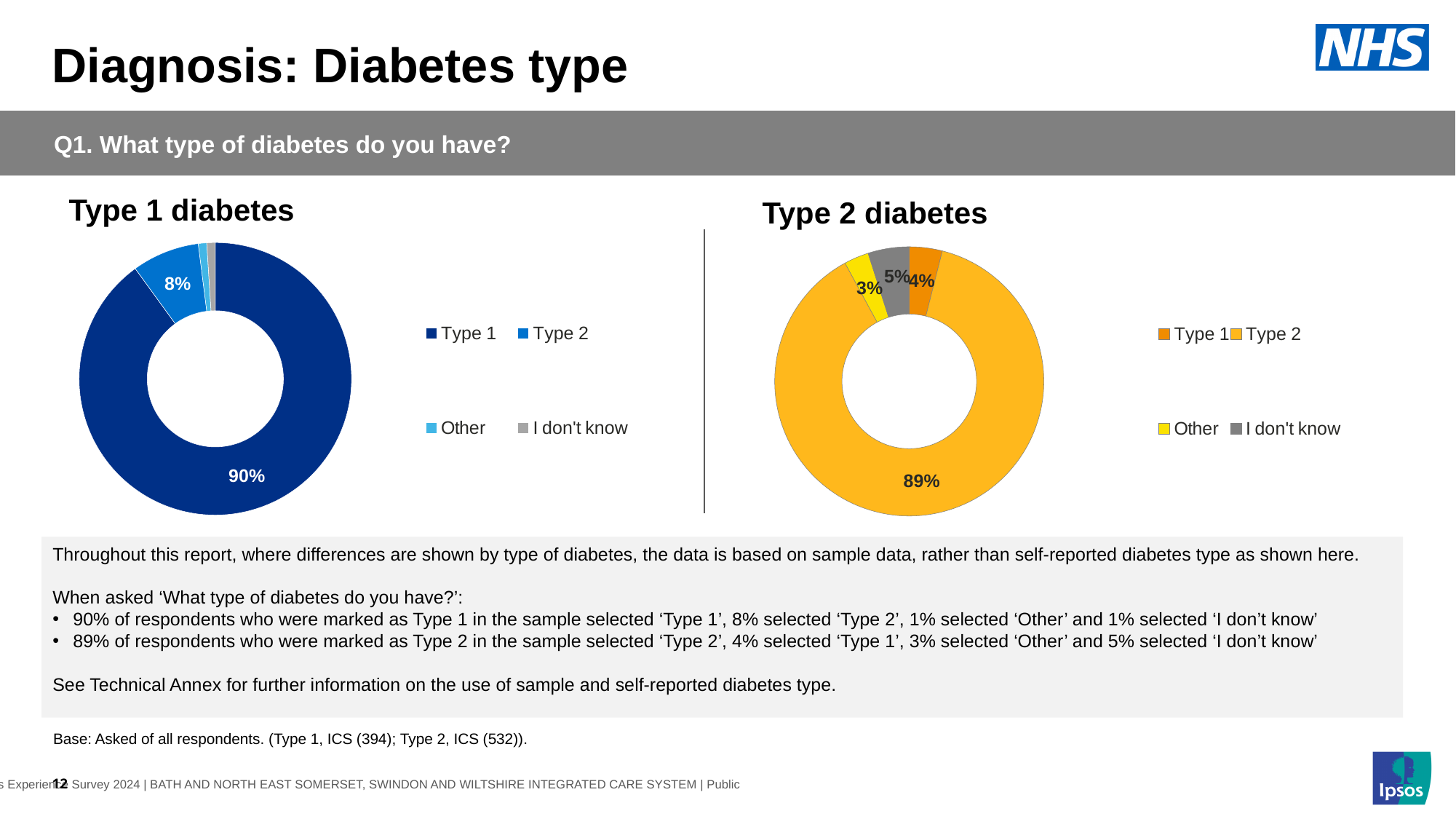
In the 'Type 2 diabetes' chart, what percentage selected 'I don't know'? 5% What kind of chart is the 'Type 1 diabetes' chart? Doughnut (pie) chart In the 'Type 2 diabetes' chart, what percentage selected 'Type 2'? 89% In the 'Type 1 diabetes' chart, what percentage selected 'Type 1'? 90% In the 'Type 1 diabetes' chart, what percentage selected 'Type 2'? 8% In the 'Type 2 diabetes' chart, what percentage selected 'Other'? 3% In the 'Type 2 diabetes' chart, which category has the smallest share? Other In the 'Type 2 diabetes' chart, which is larger: the share for 'I don't know' or the share for 'Type 1'? I don't know How many categories does the legend of the 'Type 2 diabetes' chart list? 4 In the 'Type 2 diabetes' chart, which category has the largest share? Type 2 In the 'Type 1 diabetes' chart, what is the difference between the 'Type 1' and 'Type 2' shares? 82 percentage points In the 'Type 2 diabetes' chart, what percentage selected 'Type 1'? 4%